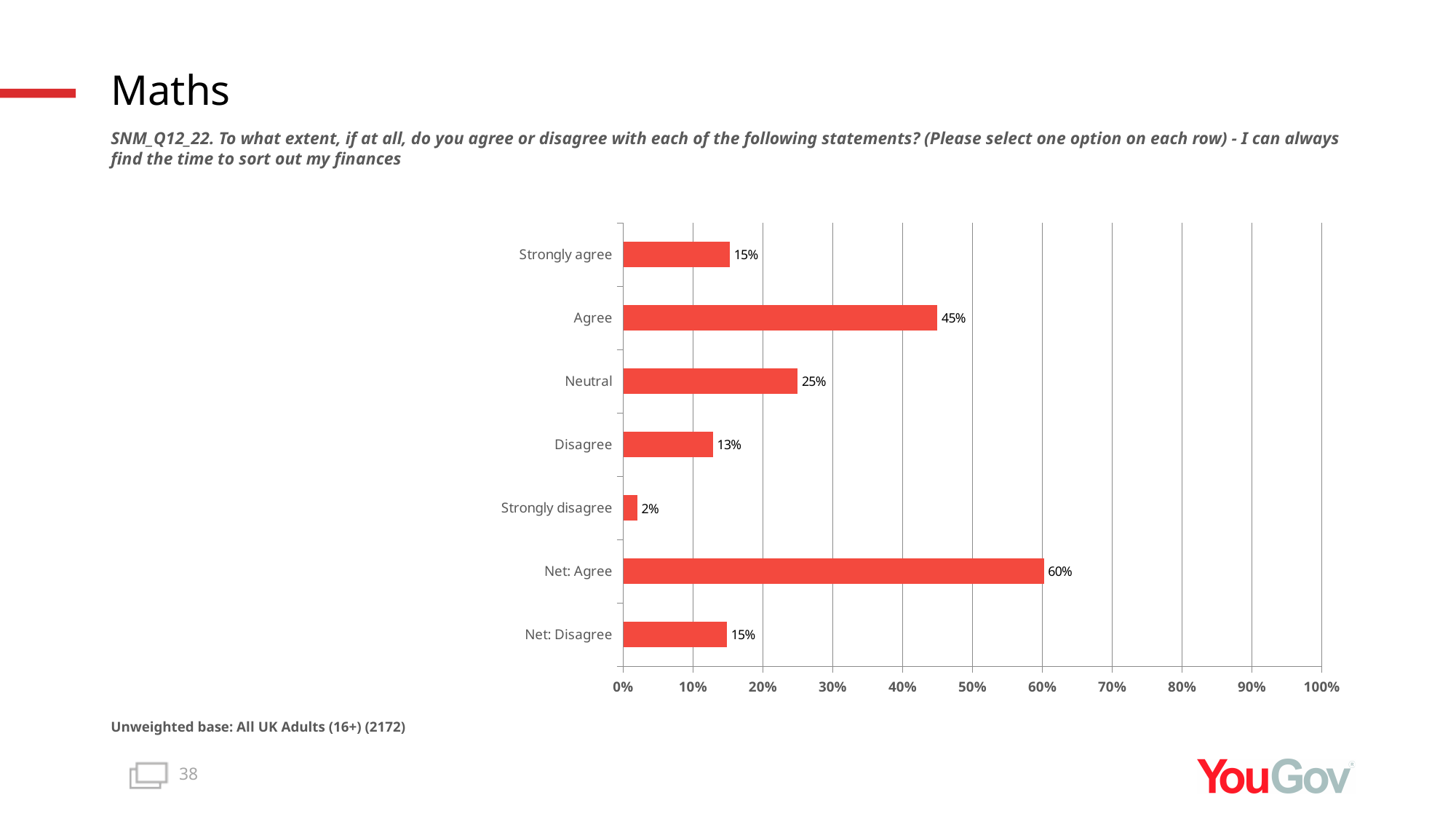
Which category has the highest value? Net: Agree What kind of chart is shown on the slide? Bar chart Which is larger, 'Neutral' or 'Strongly agree'? Neutral What is the value shown for 'Strongly disagree'? 2% What is the difference between 'Agree' and 'Disagree'? 32% What is the value shown for 'Net: Agree'? 60% How many categories are shown on the chart? 7 Which category has the lowest value? Strongly disagree What percentage of respondents selected 'Neutral'? 25% Is the value for 'Agree' greater or less than 40%? greater What percentage of respondents selected 'Agree'? 45% What is the difference between 'Net: Agree' and 'Net: Disagree'? 45%